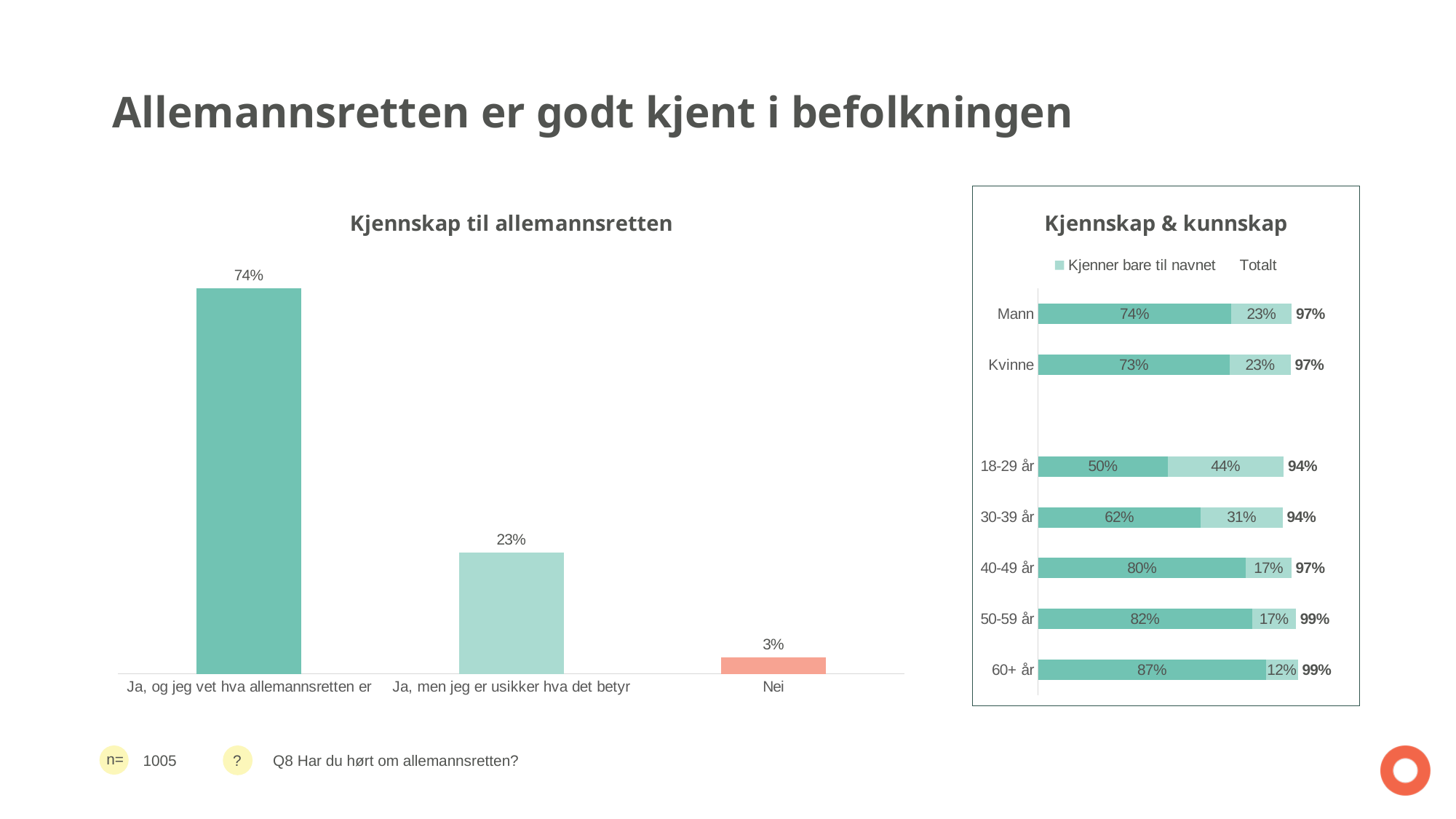
In the chart 'Kjennskap til allemannsretten', what is the value for 'Ja, men jeg er usikker hva det betyr'? 23% In the chart 'Kjennskap til allemannsretten', what is the value for 'Nei'? 3% In the chart 'Kjennskap & kunnskap', what is the total for '18-29 år'? 94% In the chart 'Kjennskap til allemannsretten', how many categories are shown? 3 In the chart 'Kjennskap & kunnskap', which category has the lowest first-segment value? 18-29 år In the chart 'Kjennskap til allemannsretten', what is the difference between 'Ja, og jeg vet hva allemannsretten er' and 'Ja, men jeg er usikker hva det betyr'? 51% In the chart 'Kjennskap til allemannsretten', which category has the highest value? Ja, og jeg vet hva allemannsretten er In the chart 'Kjennskap & kunnskap', which category has the highest first-segment value? 60+ år In the chart 'Kjennskap & kunnskap', how many categories are shown? 7 In the chart 'Kjennskap & kunnskap', what is the 'Kjenner bare til navnet' value for '30-39 år'? 31% In the chart 'Kjennskap & kunnskap', is the first-segment value larger for 'Mann' or for '40-49 år'? 40-49 år What kind of chart is 'Kjennskap til allemannsretten'? Bar chart